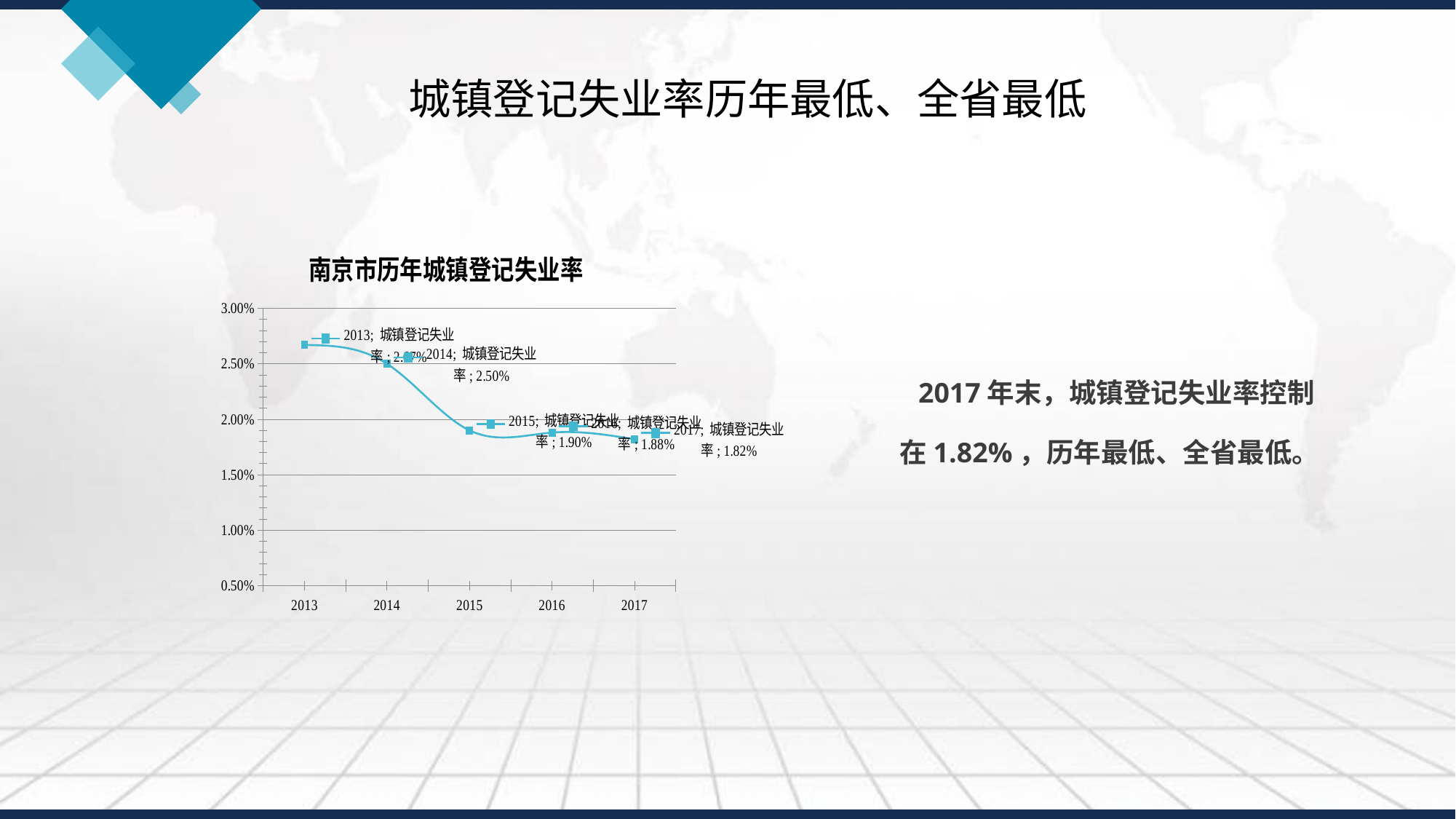
Which year has the higher 城镇登记失业率, 2015 or 2016? 2015 What is the 城镇登记失业率 for 2016 in the chart? 1.88% Which year has the lowest 城镇登记失业率 in the chart? 2017 Which year has the highest 城镇登记失业率 in the chart? 2013 Does the 城镇登记失业率 rise or fall from 2013 to 2017? fall Is the 城镇登记失业率 for 2013 greater or less than 2.50%? greater By how many percentage points did the 城镇登记失业率 fall from 2014 to 2017? 0.68 percentage points What is the 城镇登记失业率 for 2017 in the chart 南京市历年城镇登记失业率? 1.82% How many years are plotted in the chart 南京市历年城镇登记失业率? 5 What kind of chart is 南京市历年城镇登记失业率? line chart What is the 城镇登记失业率 for 2014 in the chart? 2.50% What is the 城镇登记失业率 for 2015 in the chart? 1.90%